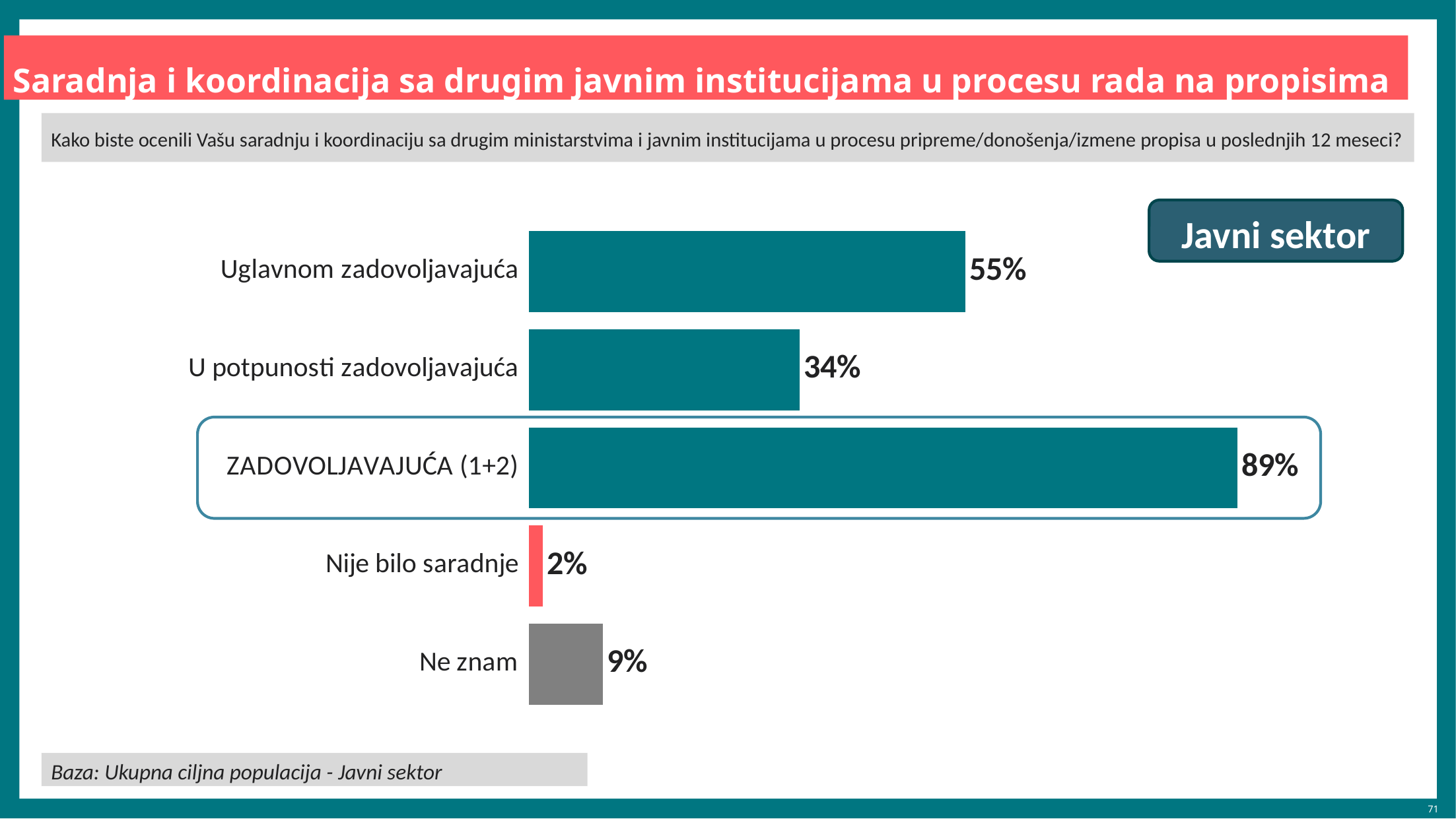
Which is larger, the value for "Ne znam" or the value for "Nije bilo saradnje"? Ne znam Which category has the highest value? ZADOVOLJAVAJUĆA (1+2) What is the value for "U potpunosti zadovoljavajuća"? 34% What is the value for "ZADOVOLJAVAJUĆA (1+2)"? 89% What kind of chart is shown on the slide? bar chart What is the value for "Nije bilo saradnje"? 2% What is the value for "Ne znam"? 9% What is the value for "Uglavnom zadovoljavajuća"? 55% What is the difference between the values for "Uglavnom zadovoljavajuća" and "U potpunosti zadovoljavajuća"? 21% What colour is the bar for "Nije bilo saradnje"? red Which category has the lowest value? Nije bilo saradnje How many categories are shown in the chart? 5